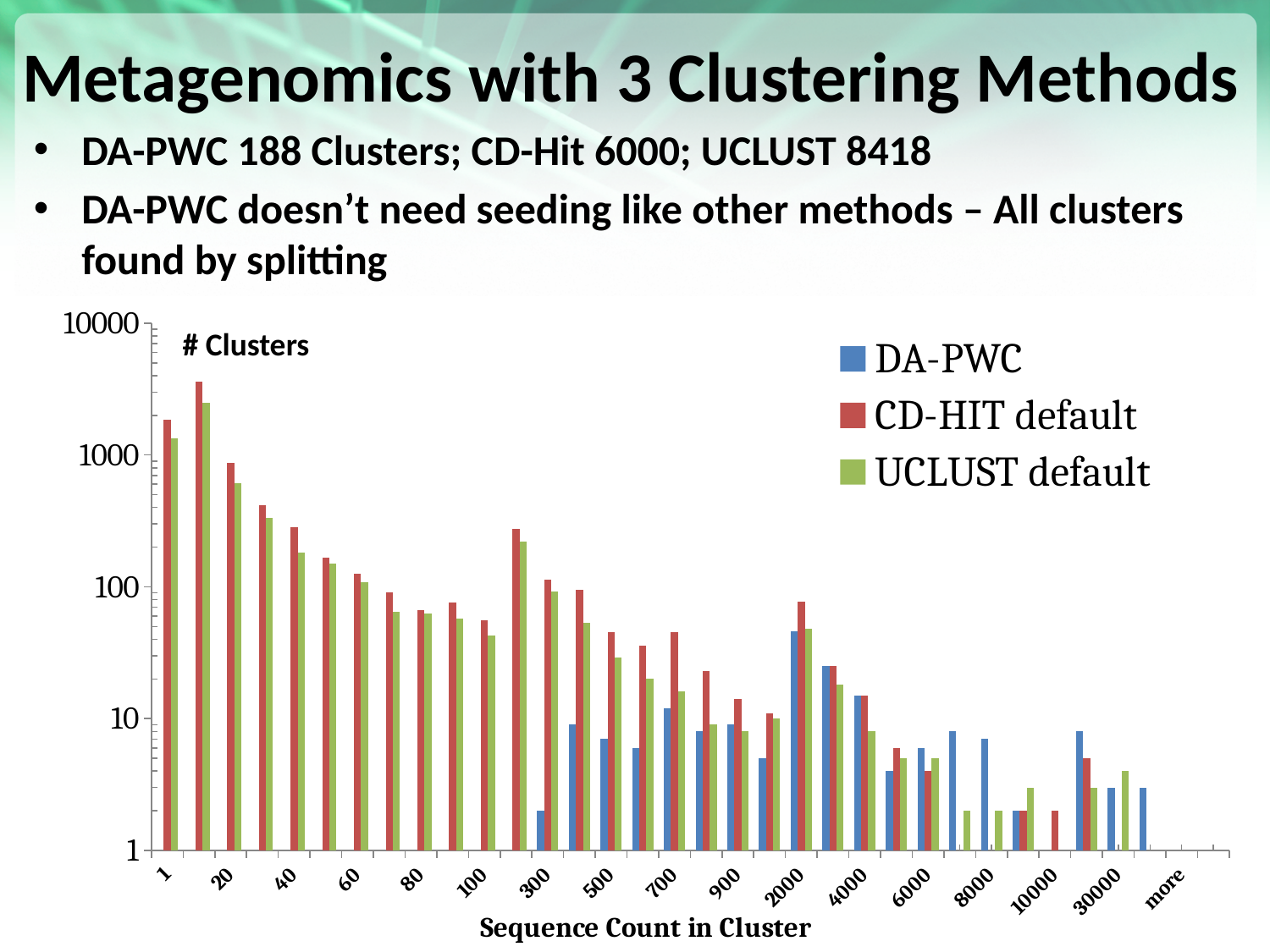
At sequence count 1, which is larger: CD-HIT default or UCLUST default? CD-HIT default Which series has the tallest bar anywhere in the chart? CD-HIT default Do the CD-HIT default values rise or fall from sequence count 1 to sequence count 100? fall How many series does the chart legend list? 3 Is the DA-PWC value at sequence count 2000 greater or less than 10? greater Is the UCLUST default value at sequence count 1 greater or less than 1000? greater What is the title of the x axis of the chart? Sequence Count in Cluster What are the three series named in the chart legend? DA-PWC, CD-HIT default, UCLUST default At sequence count 2000, which is larger: CD-HIT default or DA-PWC? CD-HIT default Is the DA-PWC value at sequence count 300 greater or less than 10? less What kind of chart is shown on the slide? bar chart